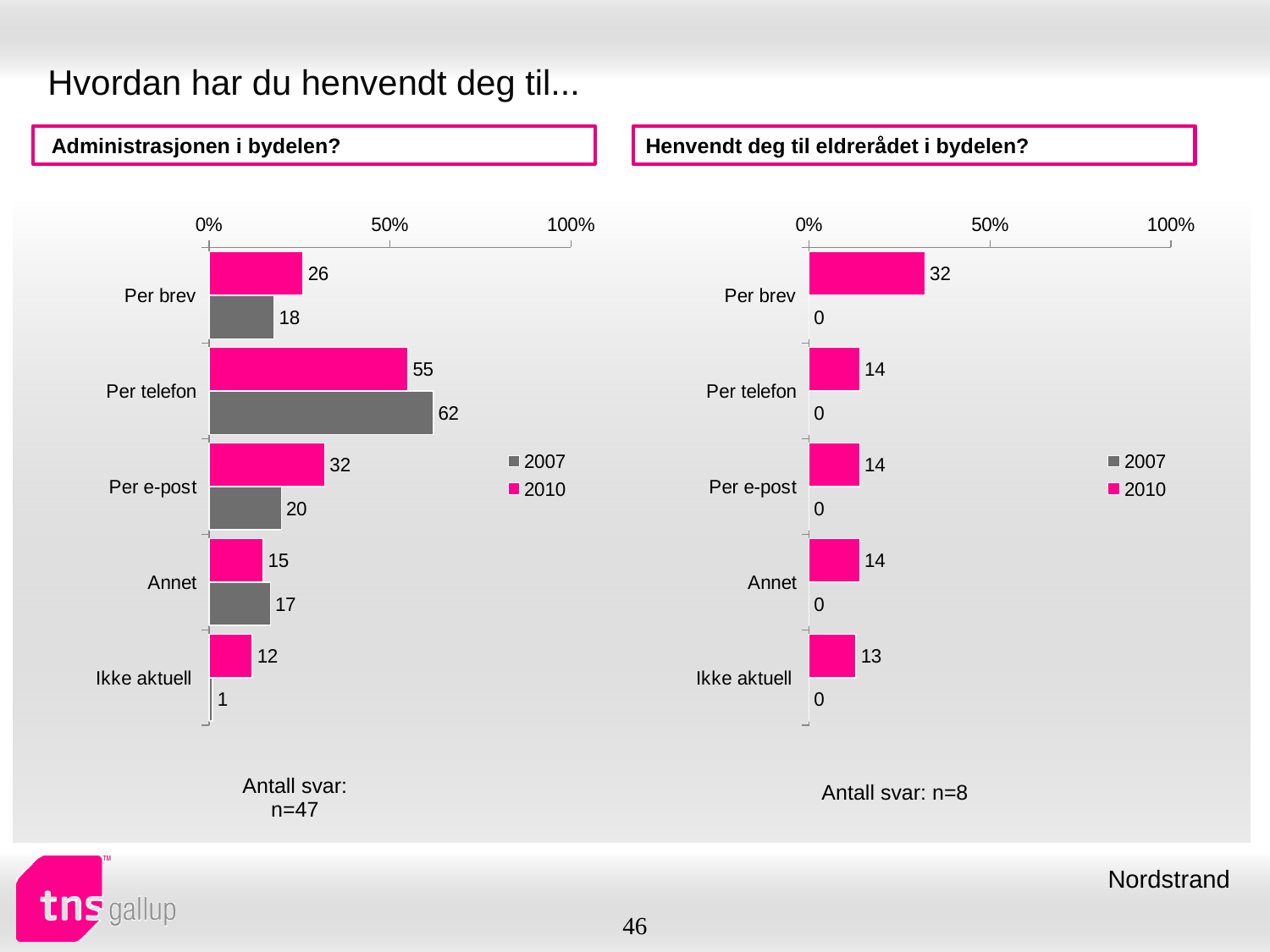
In the 'Henvendt deg til eldrerådet i bydelen?' chart, which category has the highest 2010 value? Per brev In the 'Henvendt deg til eldrerådet i bydelen?' chart, what is the value for Per brev in 2010? 32 In the 'Administrasjonen i bydelen?' chart, what is the value for Per telefon in 2007? 62 How many categories are shown in the 'Henvendt deg til eldrerådet i bydelen?' chart? 5 In the 'Administrasjonen i bydelen?' chart, what is the value for Per brev in 2010? 26 In the 'Administrasjonen i bydelen?' chart, what is the difference between the 2007 and 2010 values for Per telefon? 7 How many series does the legend of the 'Administrasjonen i bydelen?' chart list? 2 In the 'Administrasjonen i bydelen?' chart, which category has the lowest 2007 value? Ikke aktuell In the 'Administrasjonen i bydelen?' chart, which category has the highest 2010 value? Per telefon In the 'Administrasjonen i bydelen?' chart, is the 2007 value for Per telefon greater or less than 50%? greater In the 'Henvendt deg til eldrerådet i bydelen?' chart, what is the value for Ikke aktuell in 2010? 13 In the 'Administrasjonen i bydelen?' chart, which is larger for Per e-post: the 2007 value or the 2010 value? 2010